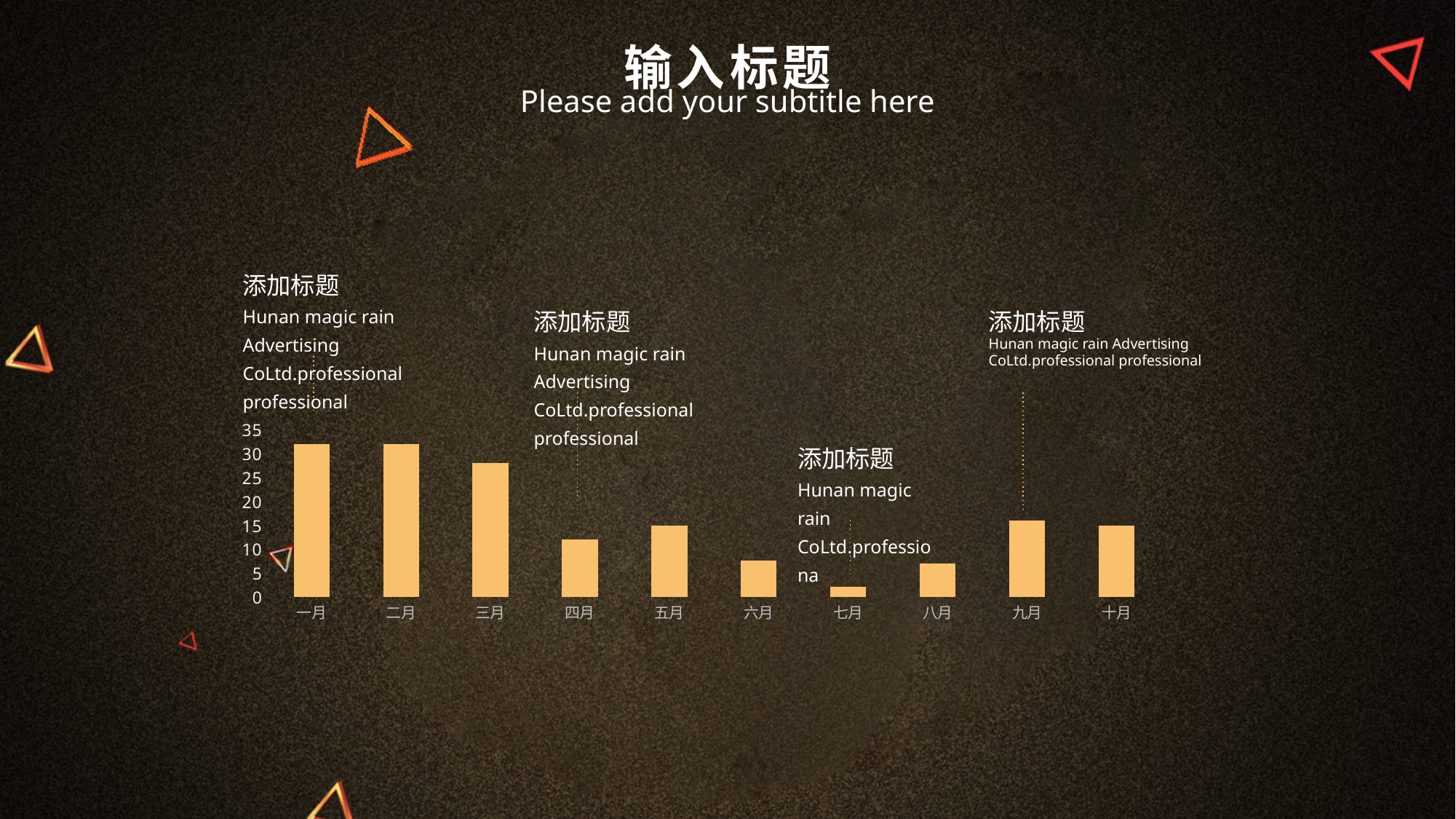
What kind of chart is shown on the slide? bar chart Is the value for 九月 greater or less than 10? greater What is the highest value shown on the chart's y axis? 35 Do the values generally rise or fall from 一月 to 七月? fall Is the value for 六月 greater or less than 10? less Is the value for 一月 greater or less than 30? greater Which is larger, the value for 三月 or the value for 四月? 三月 How many categories are shown on the x axis of the chart? 10 Which month has the lowest bar in the chart? 七月